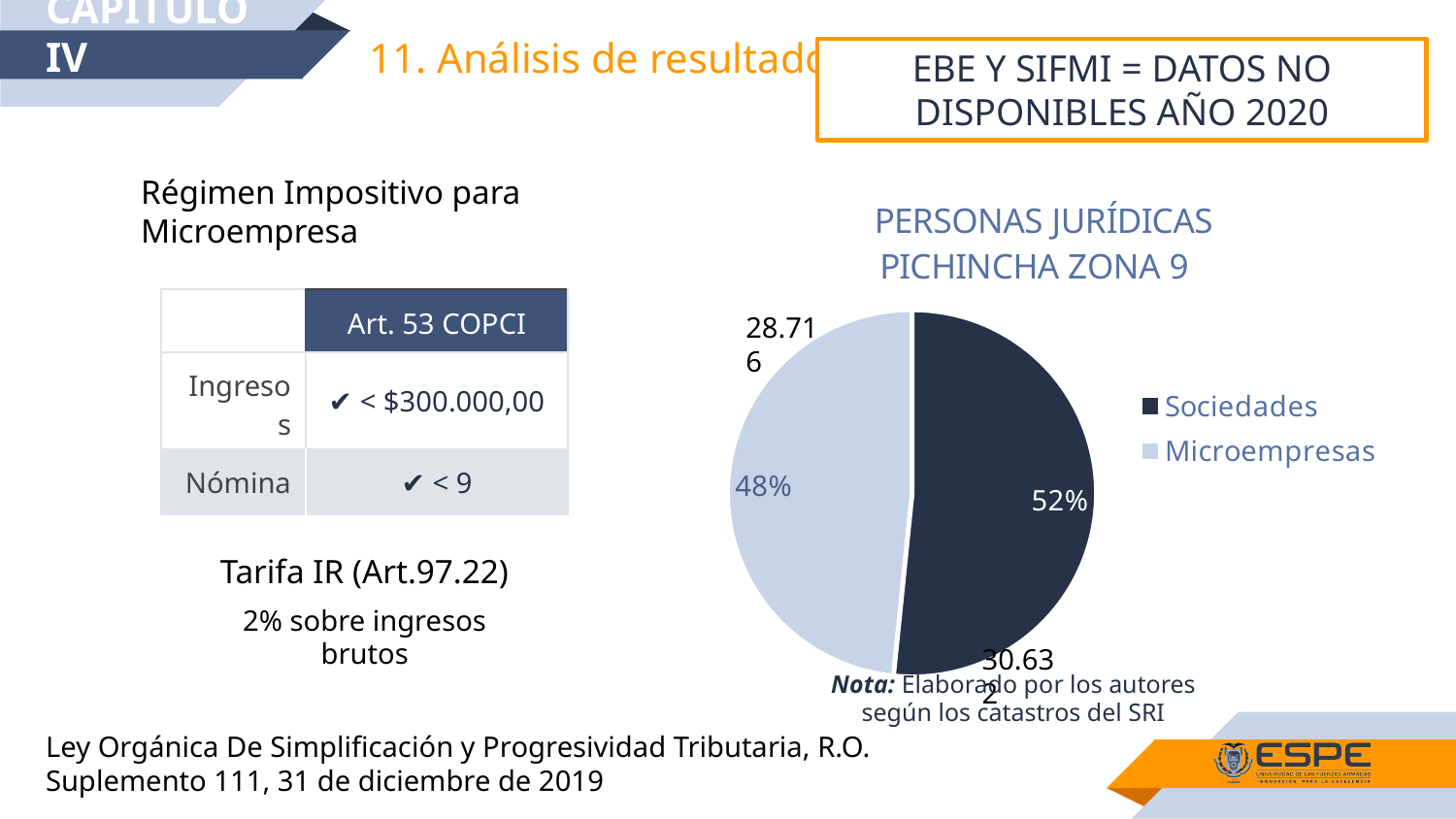
Which category has the largest slice in the pie chart? Sociedades How many slices does the pie chart have? 2 What percentage of the pie chart does Microempresas represent? 48% Which slice is larger in the pie chart, Sociedades or Microempresas? Sociedades Which category has the smallest slice in the pie chart? Microempresas What kind of chart is shown under the title 'PERSONAS JURÍDICAS PICHINCHA ZONA 9'? Pie chart By how many percentage points does the Sociedades share exceed the Microempresas share in the pie chart? 4 percentage points How many entries does the legend of the pie chart list? 2 What is the title of the pie chart? PERSONAS JURÍDICAS PICHINCHA ZONA 9 What percentage of the pie chart does Sociedades represent? 52% What numeric data label is shown next to the Microempresas slice of the pie chart? 28.716 Which legend entry of the pie chart is shown in the dark navy colour? Sociedades